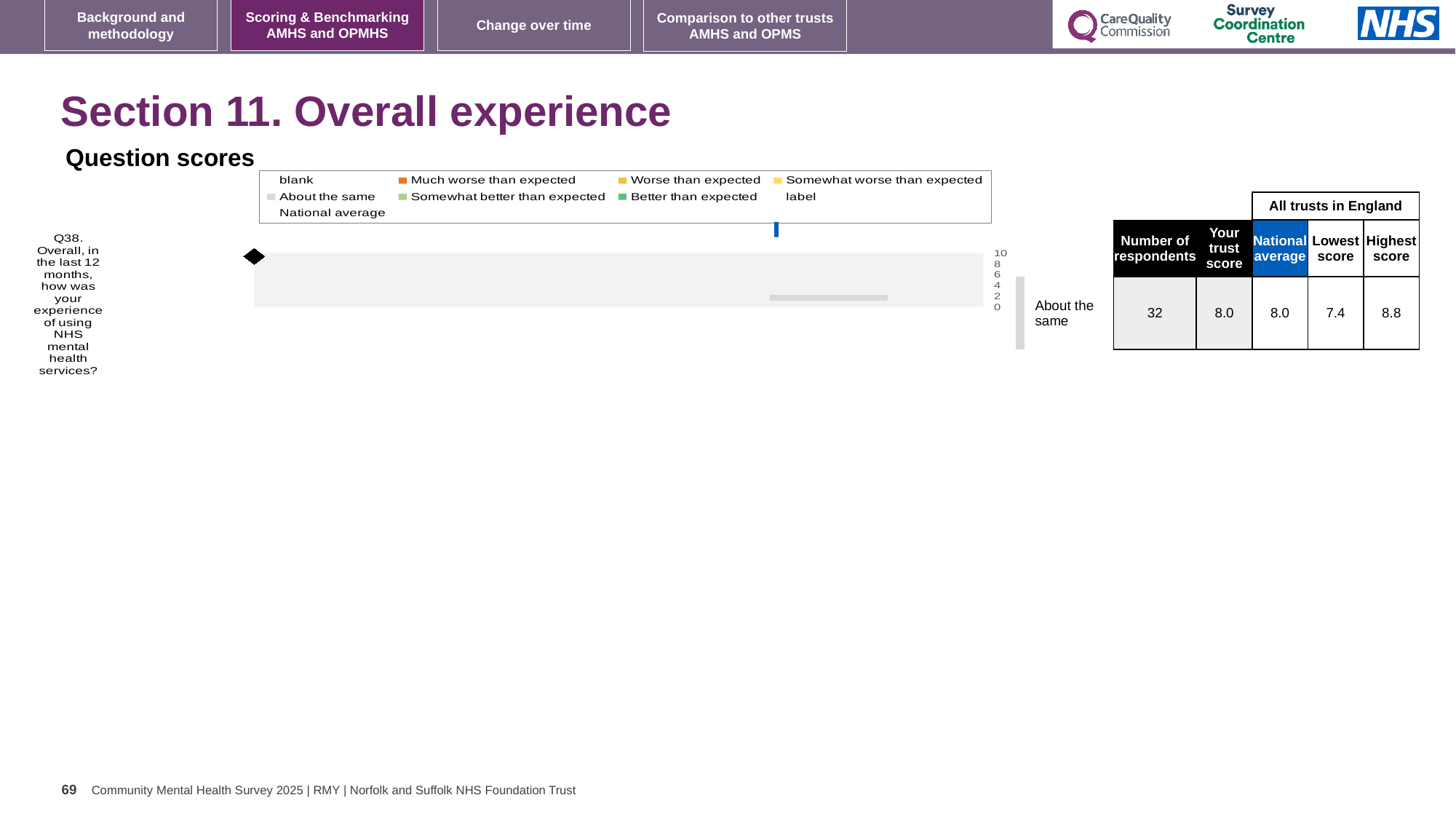
In the table beside the chart, what is the Highest score among all trusts in England for Q38? 8.8 What is the difference between the Highest score and the Lowest score for Q38 in the table beside the chart? 1.4 What is the highest value shown on the chart's axis? 10 In the table beside the chart, what is the Lowest score among all trusts in England for Q38? 7.4 In the table beside the chart, what is 'Your trust score' for Q38? 8.0 How many questions (categories) are plotted in the Question scores chart? 1 Is the trust score for Q38 larger than, smaller than, or equal to the National average in the table beside the chart? equal Which question is plotted in the Question scores chart? Q38. Overall, in the last 12 months, how was your experience of using NHS mental health services? In the table beside the chart, what is the number of respondents for Q38? 32 In the table beside the chart, what is the National average for Q38? 8.0 What kind of chart is shown under 'Question scores'? bar chart What benchmark category is shown to the right of the chart for Q38? About the same